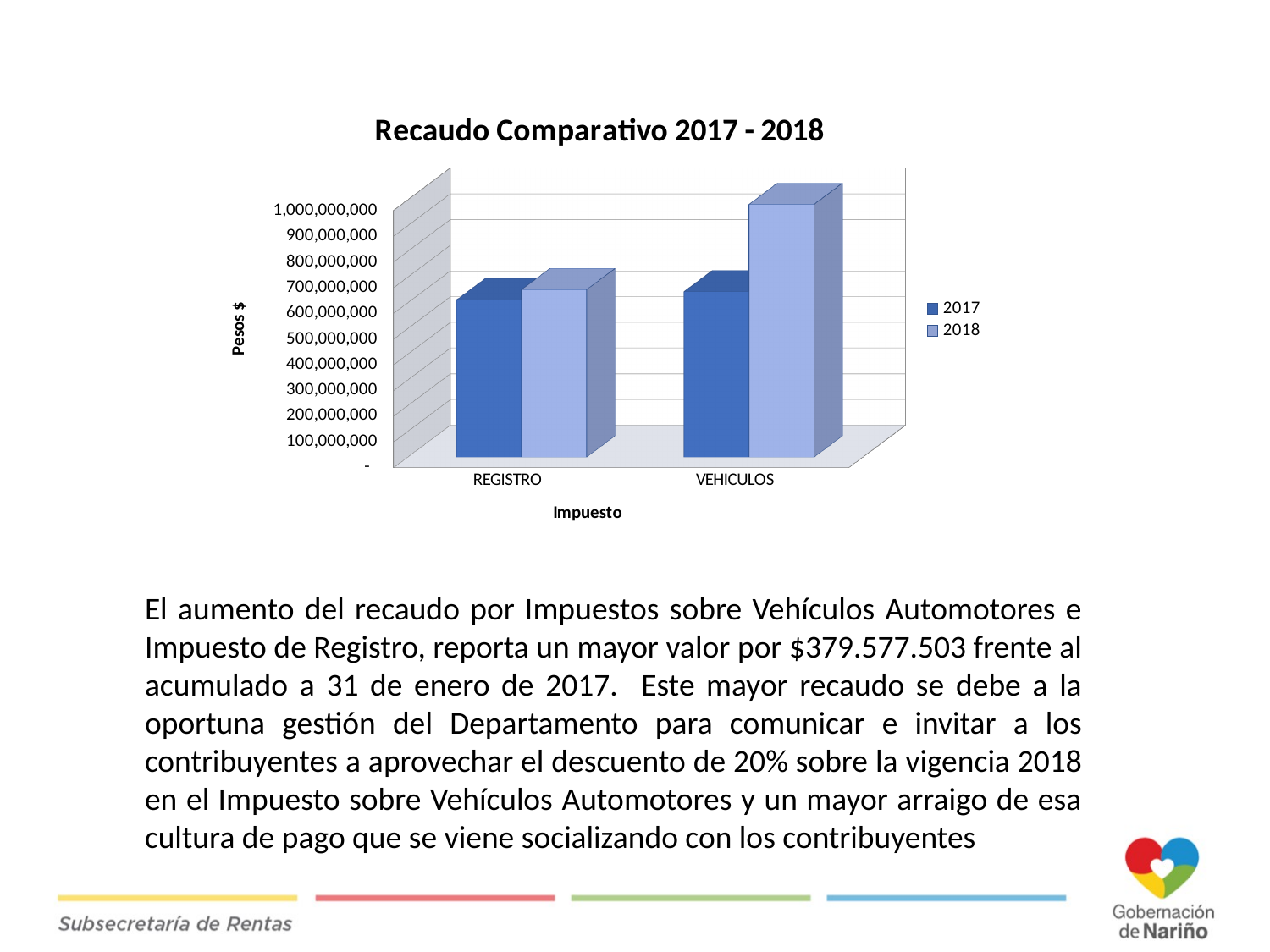
How many categories are shown on the x axis of the chart? 2 Which category and series has the highest bar in the chart? VEHICULOS, 2018 Is the 2018 value for VEHICULOS greater or less than 900,000,000? greater Is the 2018 value for REGISTRO greater or less than 800,000,000? less Is the 2017 value for REGISTRO greater or less than 500,000,000? greater For the 2018 series, which category has the larger value, REGISTRO or VEHICULOS? VEHICULOS For VEHICULOS, which year has the larger value, 2017 or 2018? 2018 What is the label of the vertical axis of the chart? Pesos $ What type of chart is shown on the slide? Bar chart How many series does the chart legend list? 2 What is the title of the chart? Recaudo Comparativo 2017 - 2018